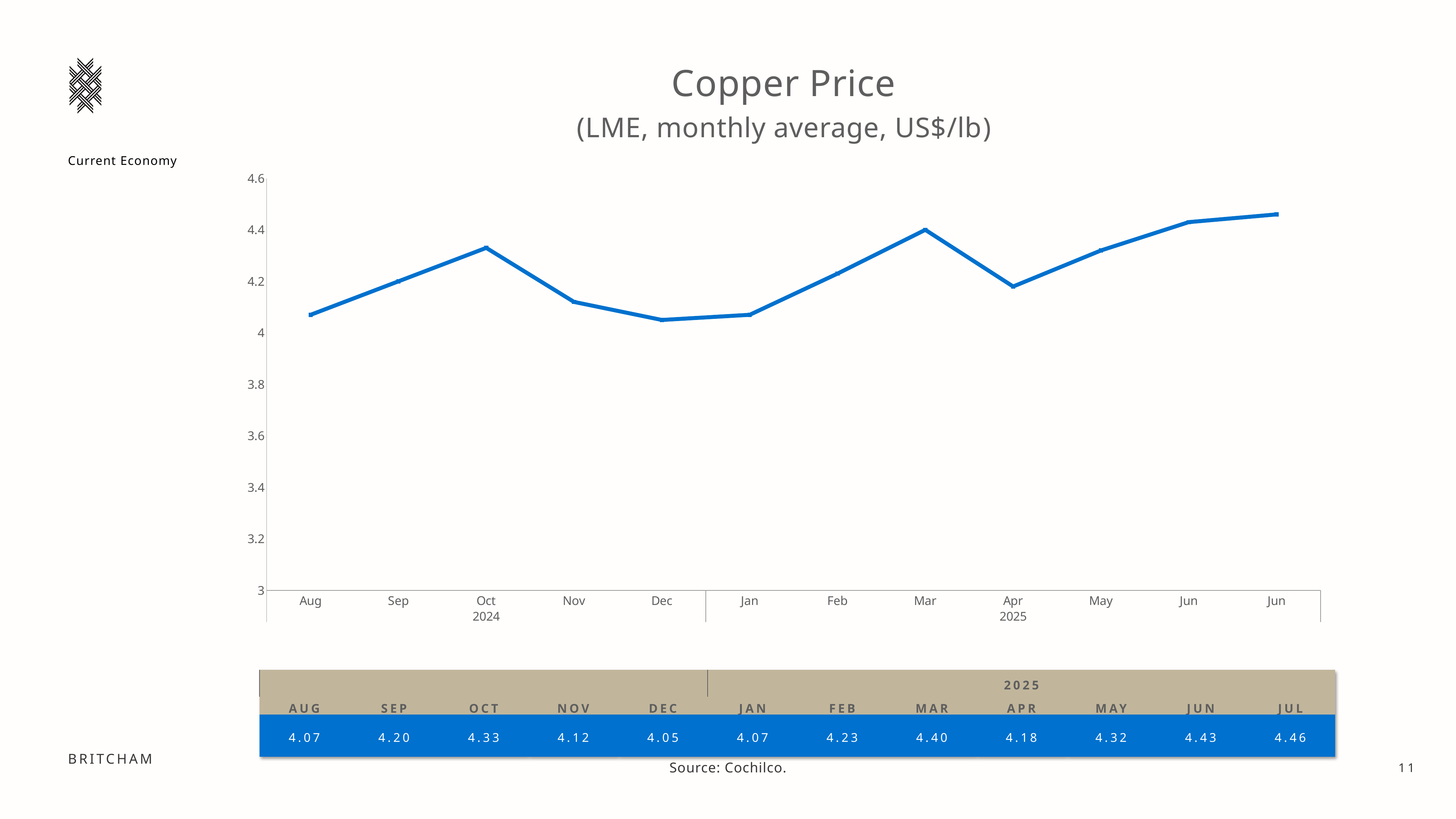
What is the difference between the copper price in March 2025 and April 2025? 0.22 Is the copper price in November 2024 greater or less than 4? greater Which month has the highest copper price? Jul 2025 How many monthly data points are plotted on the chart? 12 Which is higher, the copper price in October 2024 or in February 2025? October 2024 What was the copper price in March 2025? 4.40 Which month has the lowest copper price? Dec 2024 What kind of chart is shown on the slide? line chart What is the source cited for the chart? Cochilco What was the copper price in December 2024? 4.05 Does the copper price rise or fall from January 2025 to March 2025? rise What was the copper price in October 2024? 4.33